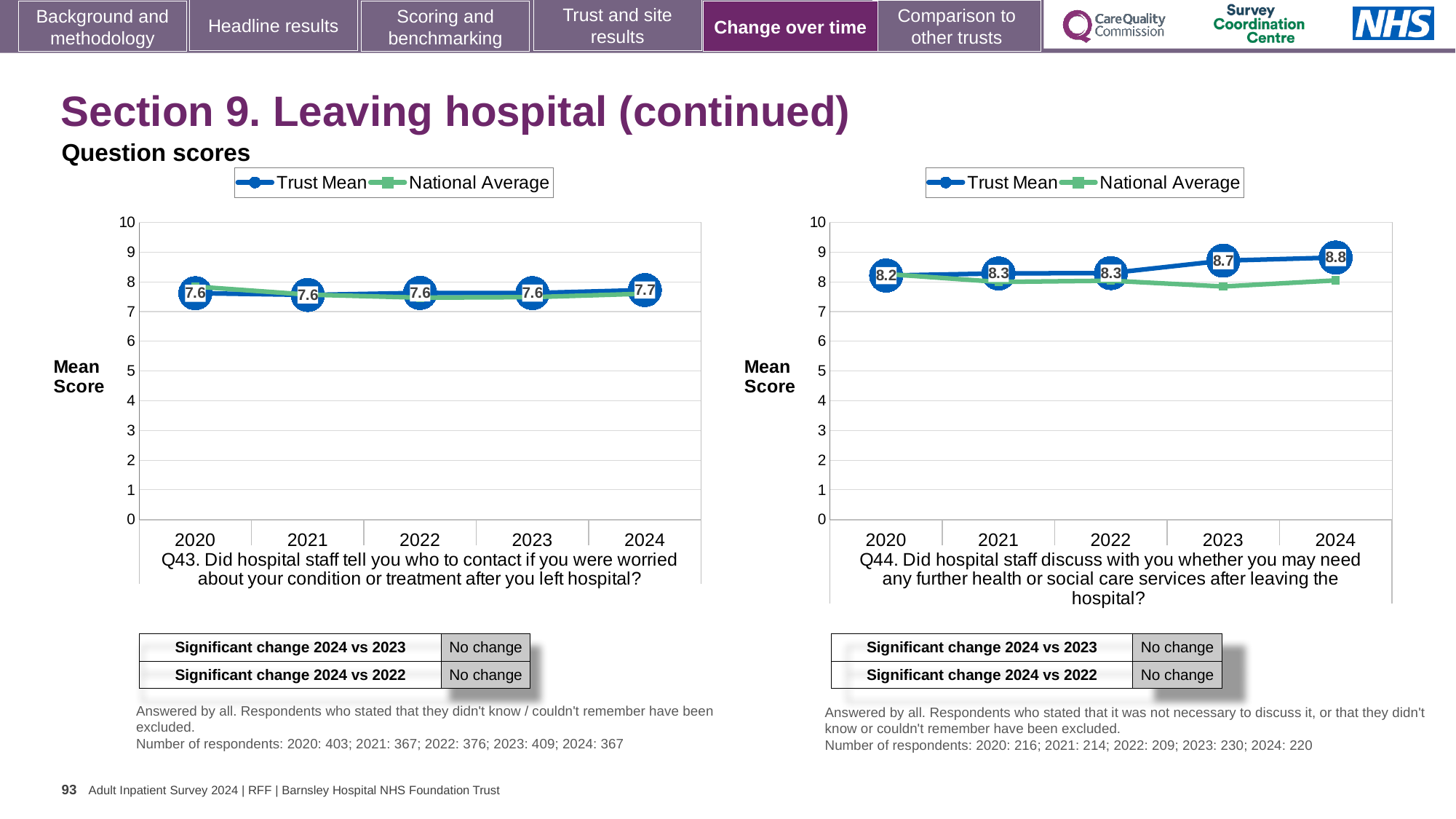
In the Q44 chart on the right, which year has the lowest Trust Mean score? 2020 How many series does the legend of the Q44 chart on the right list? 2 What kind of chart is the Q43 chart on the left? line chart In the Q44 chart on the right, what is the difference between the Trust Mean scores for 2024 and 2020? 0.6 In the Q43 chart on the left, is the Trust Mean score for 2024 higher or lower than for 2023? higher In the Q44 chart on the right, is the Trust Mean value for 2024 greater or less than 8? greater In the Q44 chart on the right, what is the Trust Mean score for 2023? 8.7 In the Q43 chart on the left, what is the Trust Mean score for 2024? 7.7 In the Q44 chart on the right, which year has the highest Trust Mean score? 2024 In the Q44 chart on the right, does the Trust Mean rise or fall from 2020 to 2024? rise In the Q44 chart on the right, what is the Trust Mean score for 2020? 8.2 How many years are plotted on the x axis of the Q43 chart on the left? 5